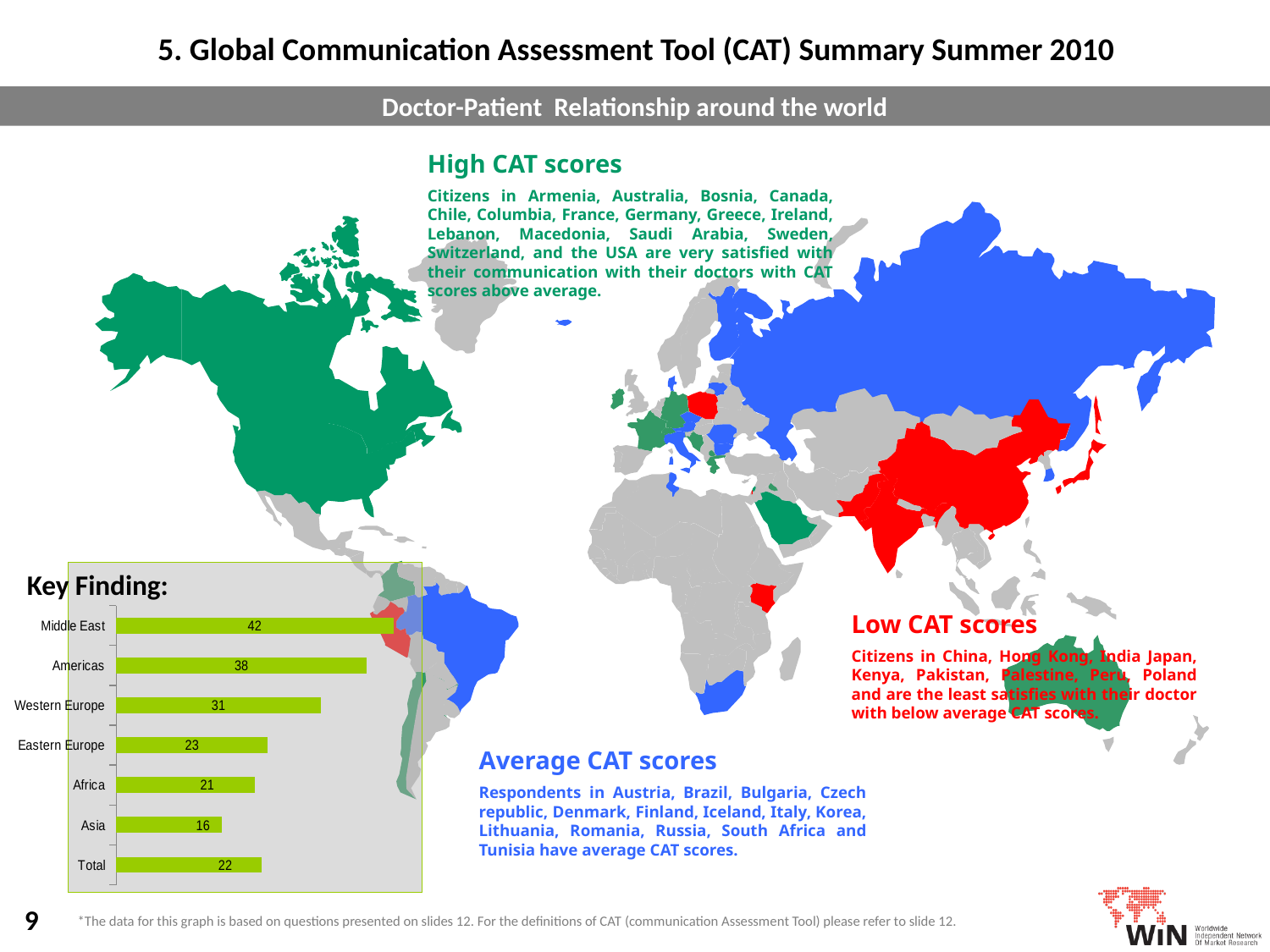
Which region has the lowest value in the bar chart? Asia What is the Total value shown in the bar chart? 22 What kind of chart is shown on the slide? bar chart What is the difference between the values for the Middle East and the Americas in the bar chart? 4 What is the value for Western Europe in the bar chart? 31 Which region has the highest value in the bar chart? Middle East How many bars are shown in the bar chart? 7 What is the difference between the values for Eastern Europe and Africa in the bar chart? 2 What colour are the bars in the chart? green Which has a larger value in the bar chart, Western Europe or Eastern Europe? Western Europe What is the value for Asia in the bar chart? 16 What is the value for the Middle East in the bar chart? 42